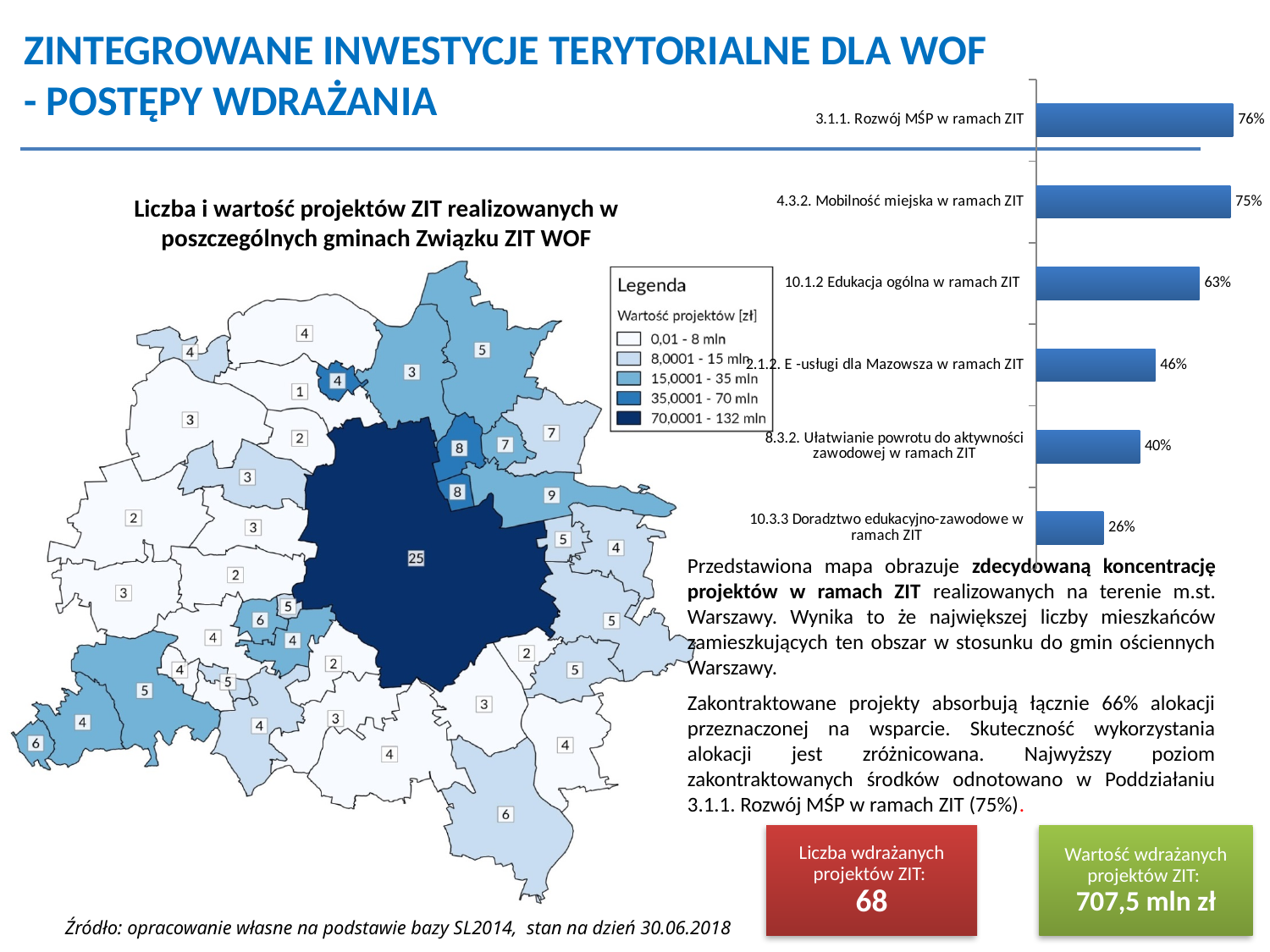
How many categories does the bar chart show? 6 In the bar chart, which category has the lowest value? 10.3.3 Doradztwo edukacyjno-zawodowe w ramach ZIT In the bar chart, what is the value for 4.3.2. Mobilność miejska w ramach ZIT? 75% In the bar chart, which category has the highest value? 3.1.1. Rozwój MŚP w ramach ZIT In the bar chart, what is the difference between the values for 10.1.2 Edukacja ogólna w ramach ZIT and 2.1.2. E-usługi dla Mazowsza w ramach ZIT? 17% In the bar chart, what is the value for 10.1.2 Edukacja ogólna w ramach ZIT? 63% In the bar chart, what is the value for 3.1.1. Rozwój MŚP w ramach ZIT? 76% What kind of chart is shown on the right side of the slide? bar chart In the bar chart, which is larger: the value for 8.3.2. Ułatwianie powrotu do aktywności zawodowej w ramach ZIT or the value for 10.3.3 Doradztwo edukacyjno-zawodowe w ramach ZIT? 8.3.2. Ułatwianie powrotu do aktywności zawodowej w ramach ZIT In the bar chart, what is the value for 2.1.2. E-usługi dla Mazowsza w ramach ZIT? 46% In the bar chart, what is the value for 10.3.3 Doradztwo edukacyjno-zawodowe w ramach ZIT? 26% In the bar chart, what is the value for 8.3.2. Ułatwianie powrotu do aktywności zawodowej w ramach ZIT? 40%